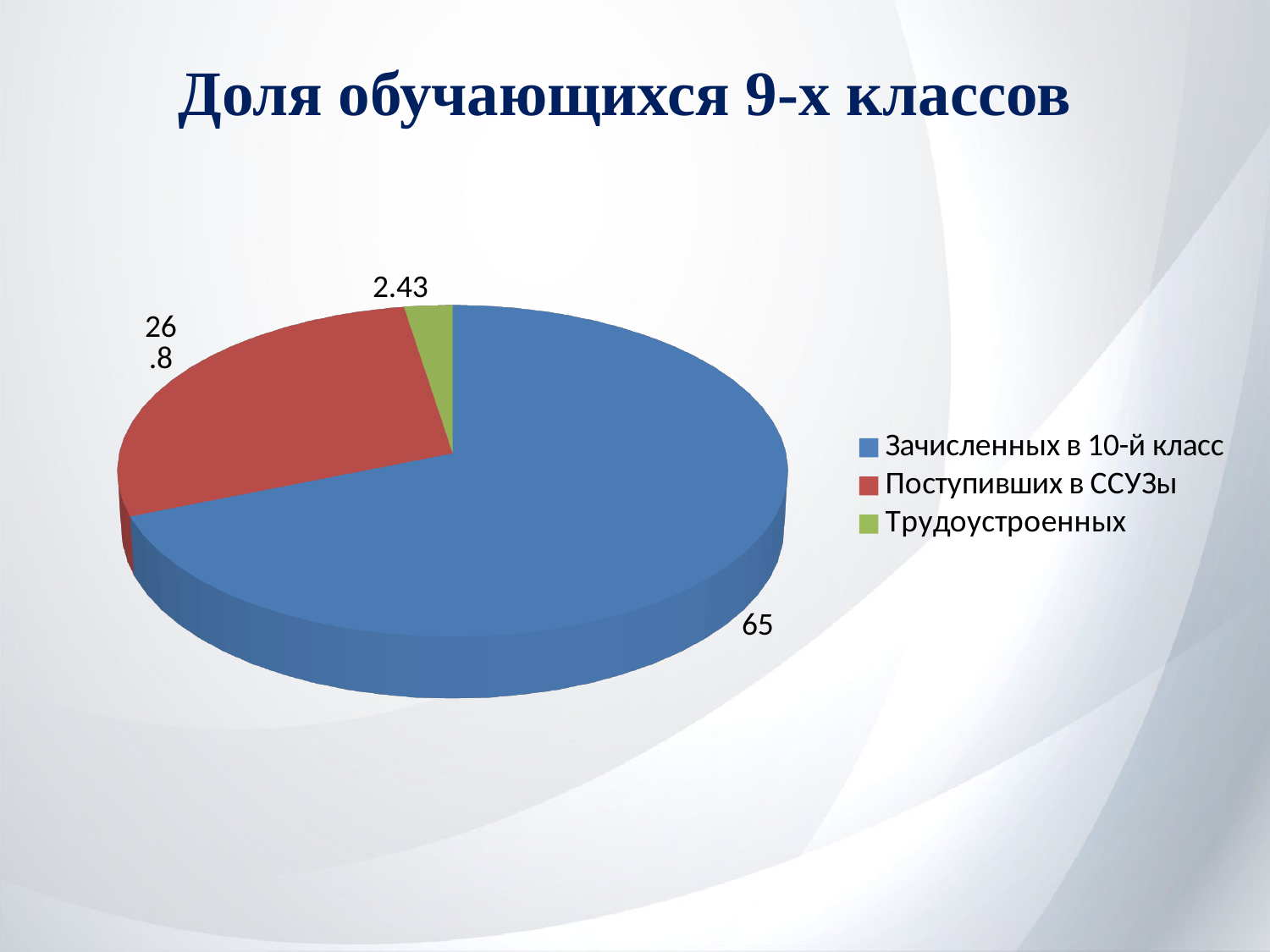
Which category has the largest slice of the pie? Зачисленных в 10-й класс What kind of chart is shown on the slide? Pie chart How many slices does the pie chart have? 3 Which is larger, the value for Поступивших в ССУЗы or the value for Трудоустроенных? Поступивших в ССУЗы What value is shown for Зачисленных в 10-й класс? 65 What is the difference between the values for Поступивших в ССУЗы and Трудоустроенных? 24.37 What colour is the slice for Трудоустроенных? Green What value is shown for Поступивших в ССУЗы? 26.8 What is the title of the chart? Доля обучающихся 9-х классов Which category has the smallest slice of the pie? Трудоустроенных What value is shown for Трудоустроенных? 2.43 What is the difference between the values for Зачисленных в 10-й класс and Поступивших в ССУЗы? 38.2